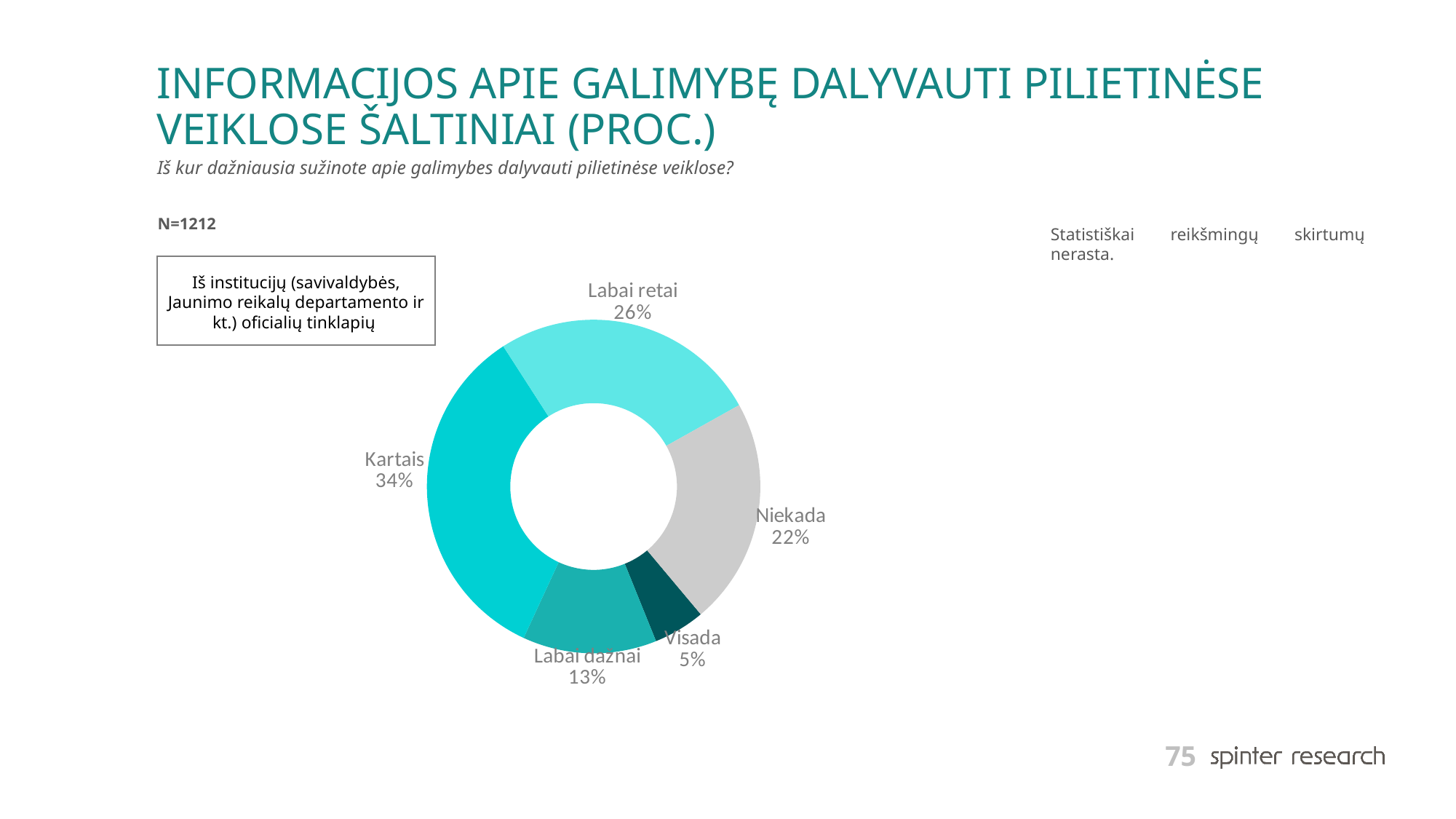
How many categories are shown in the chart? 5 What percentage is shown for "Visada"? 5% What is the difference in percentage points between "Kartais" and "Niekada"? 12 What kind of chart is shown on the slide? Doughnut (pie) chart Which category has the largest share of the chart? Kartais What percentage is shown for "Niekada"? 22% What percentage is shown for "Kartais"? 34% What is the sample size (N) stated on the slide? N=1212 What percentage is shown for "Labai dažnai"? 13% Which is larger, the share for "Labai retai" or the share for "Labai dažnai"? Labai retai Which category has the smallest share of the chart? Visada What percentage is shown for "Labai retai"? 26%